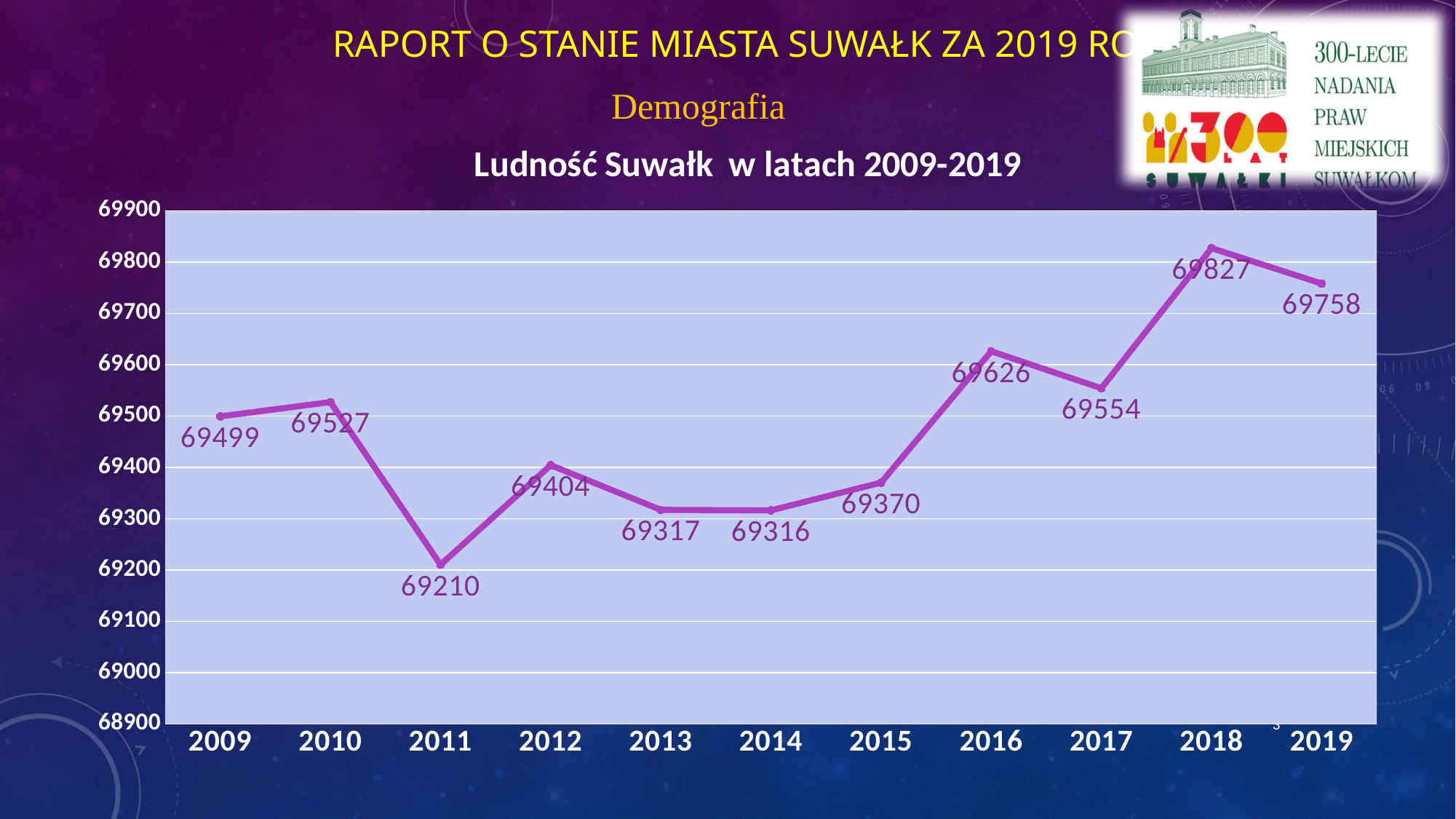
What was the population of Suwałki in 2019? 69758 What was the population of Suwałki in 2014? 69316 What was the population of Suwałki in 2018? 69827 What is the difference in population between 2018 and 2019? 69 What is the title of the chart? Ludność Suwałk w latach 2009-2019 Which year had a larger population, 2009 or 2010? 2010 Which year had the highest population? 2018 What kind of chart is shown on the slide? line chart How many years are plotted on the chart? 11 What is the difference in population between 2016 and 2017? 72 What was the population of Suwałki in 2011? 69210 Which year had the lowest population? 2011